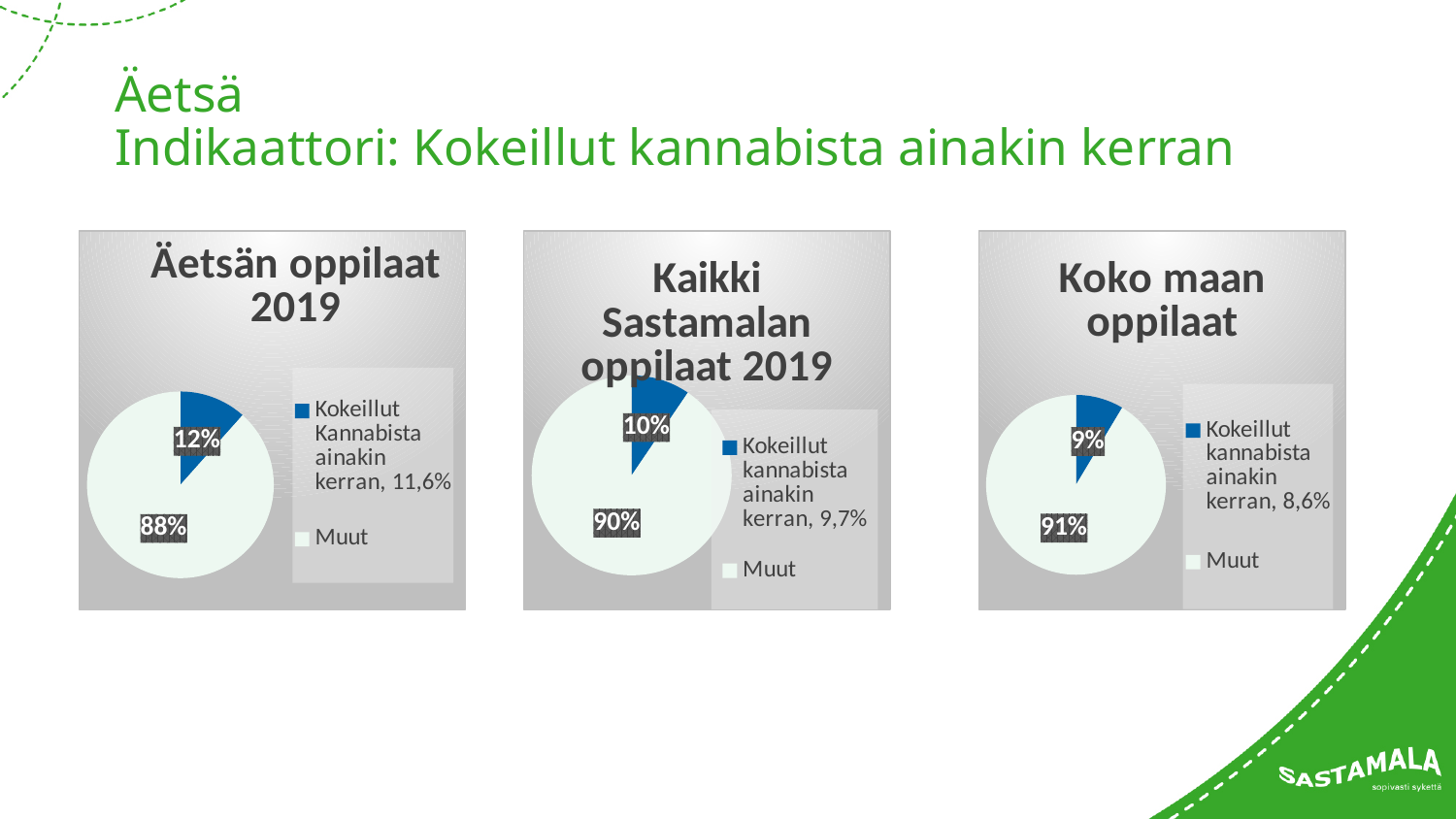
In the 'Äetsän oppilaat 2019' chart, what percentage is shown on the 'Muut' slice? 88% What type of chart is 'Koko maan oppilaat'? Pie chart How many slices does the 'Kaikki Sastamalan oppilaat 2019' pie chart have? 2 In the 'Äetsän oppilaat 2019' chart, which slice is the largest? Muut Which is larger: the 'Kokeillut kannabista ainakin kerran' share in the 'Äetsän oppilaat 2019' chart or in the 'Koko maan oppilaat' chart? Äetsän oppilaat 2019 How many charts are shown on the slide? 3 In the 'Koko maan oppilaat' chart, what value does the legend give for 'Kokeillut kannabista ainakin kerran'? 8,6% In the 'Kaikki Sastamalan oppilaat 2019' chart, what percentage is shown on the 'Muut' slice? 90% In the 'Koko maan oppilaat' chart, what percentage is shown on the 'Muut' slice? 91% In the 'Kaikki Sastamalan oppilaat 2019' chart, what value does the legend give for 'Kokeillut kannabista ainakin kerran'? 9,7% In the 'Äetsän oppilaat 2019' chart, what share of the pie is labelled 'Kokeillut Kannabista ainakin kerran'? 12% In the 'Äetsän oppilaat 2019' chart, what value does the legend give for 'Kokeillut Kannabista ainakin kerran'? 11,6%